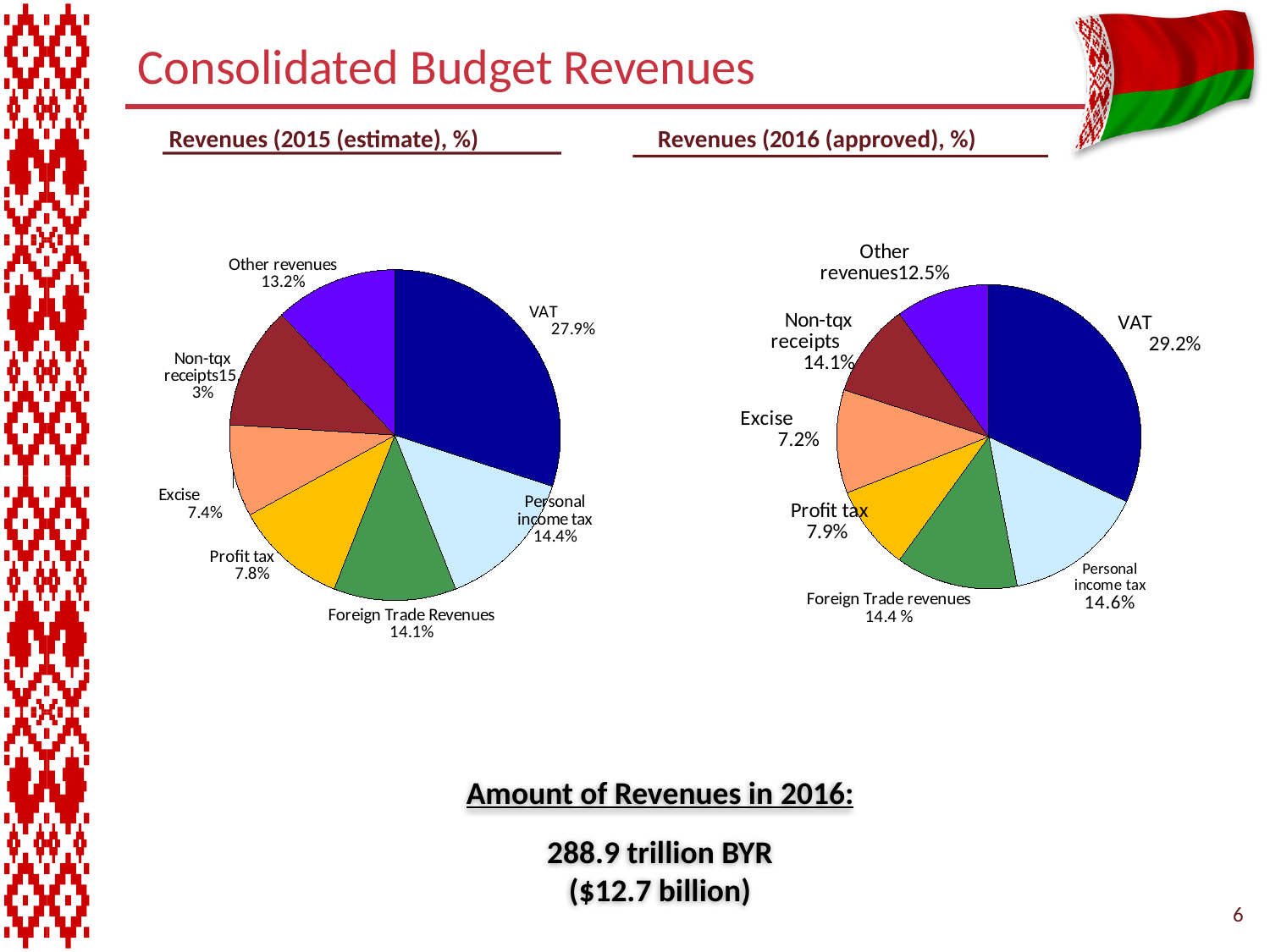
In the Revenues (2016 (approved), %) chart, what share does VAT have? 29.2% In the Revenues (2016 (approved), %) chart, what is the share for Personal income tax? 14.6% In the Revenues (2015 (estimate), %) chart, which category has the largest slice? VAT How many slices does the Revenues (2016 (approved), %) chart have? 7 In the Revenues (2016 (approved), %) chart, which category has the smallest slice? Excise In the Revenues (2015 (estimate), %) chart, what is the share for Other revenues? 13.2% In the Revenues (2015 (estimate), %) chart, what share does VAT have? 27.9% What type of chart is used for Revenues (2015 (estimate), %)? Pie chart In the Revenues (2015 (estimate), %) chart, which is larger, Profit tax or Excise? Profit tax In the Revenues (2016 (approved), %) chart, what is the difference between the VAT share and the Personal income tax share? 14.6% In the Revenues (2016 (approved), %) chart, what is the share for Excise? 7.2% In the Revenues (2015 (estimate), %) chart, which category has the smallest slice? Excise